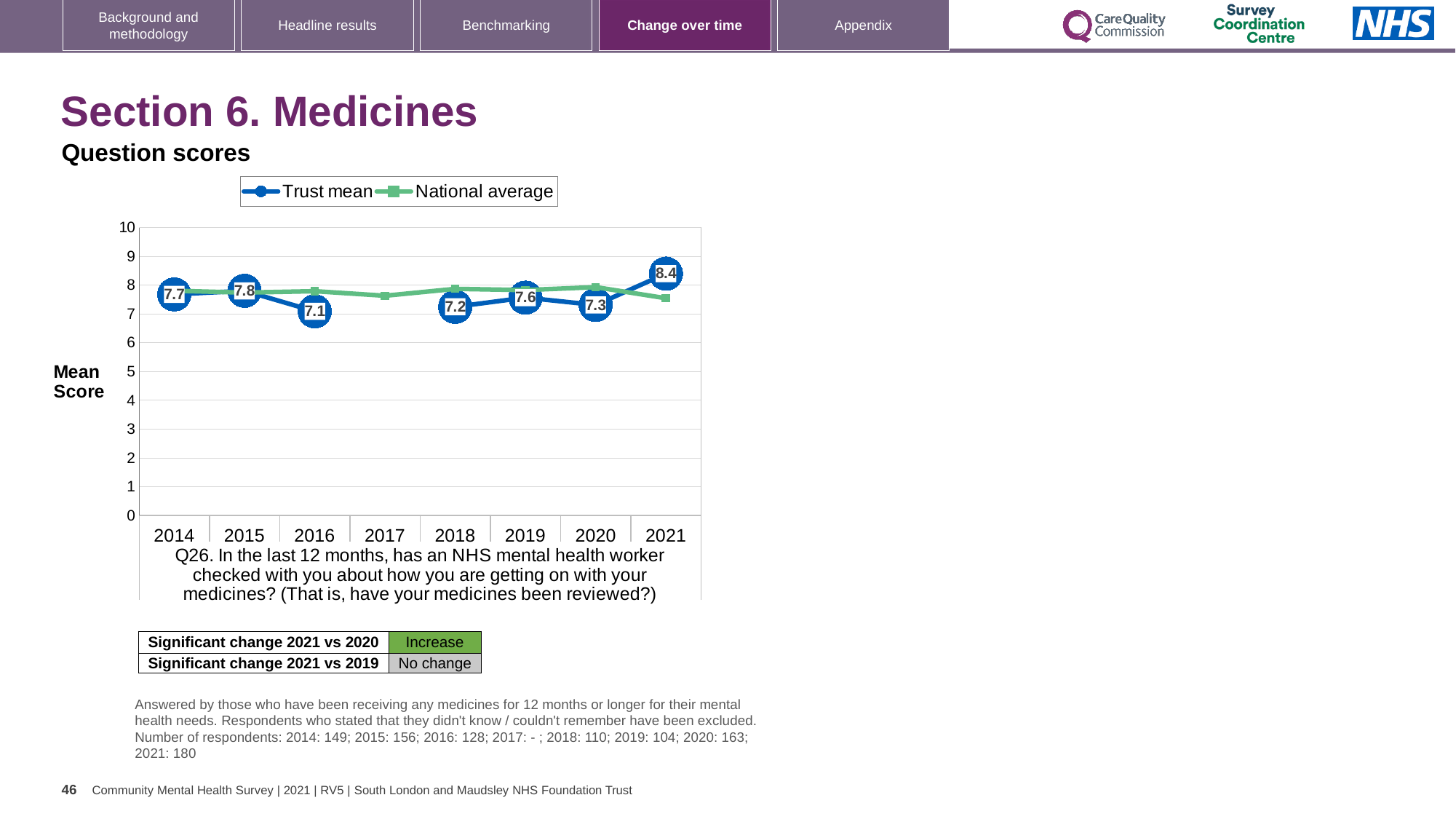
What kind of chart is shown on the slide? Line chart How many series does the chart legend list? 2 In which year is the Trust mean score highest? 2021 How many years are shown on the x axis of the chart? 8 Does the Trust mean score rise or fall from 2020 to 2021? Rise What is the Trust mean score for 2016? 7.1 Which year has the larger Trust mean score, 2015 or 2018? 2015 What is the Trust mean score for 2014? 7.7 In which year is the Trust mean score lowest? 2016 Is the National average value for 2017 greater or less than 5? greater What is the difference between the Trust mean scores for 2021 and 2020? 1.1 What is the Trust mean score for 2021? 8.4